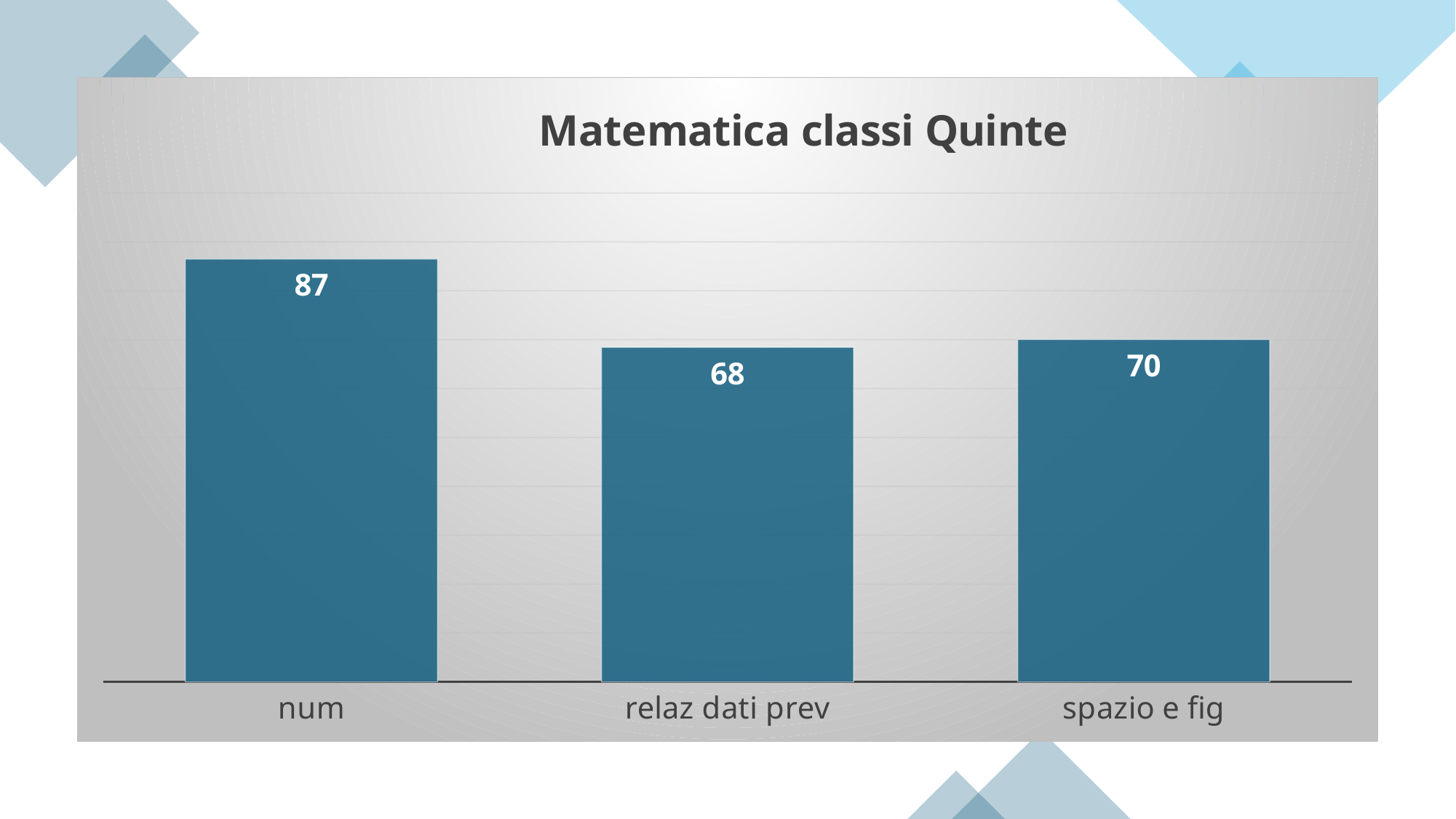
What is the value for relaz dati prev? 68 How many categories are shown on the x axis? 3 Which category has the lowest value? relaz dati prev What kind of chart is shown on the slide? bar chart What is the difference between the values for spazio e fig and relaz dati prev? 2 What is the title of the chart? Matematica classi Quinte What is the value for num? 87 Which category has the highest value? num What is the total of the three values shown? 225 What is the value for spazio e fig? 70 Which is larger, the value for num or the value for spazio e fig? num What is the difference between the values for num and relaz dati prev? 19